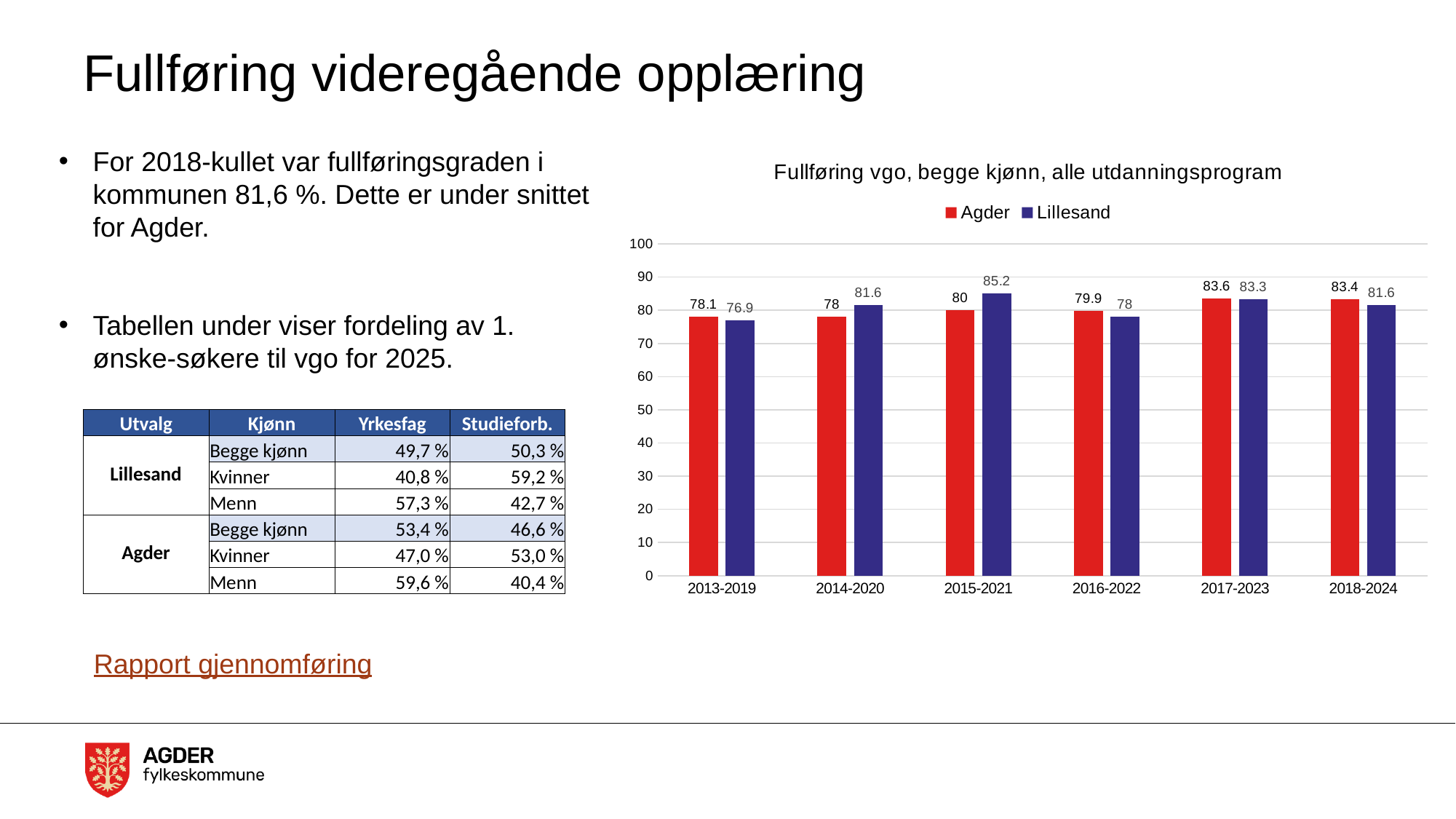
What is the value for Lillesand in 2018-2024? 81.6 What is the difference between the Lillesand and Agder values in 2015-2021? 5.2 Which is larger in 2016-2022, Agder or Lillesand? Agder What is the title of the chart? Fullføring vgo, begge kjønn, alle utdanningsprogram How many periods are shown on the x axis? 6 Which is larger in 2014-2020, Agder or Lillesand? Lillesand How many series does the legend list? 2 What is the value for Agder in 2013-2019? 78.1 In which period is the Agder value highest? 2017-2023 In which period is the Lillesand value lowest? 2013-2019 What kind of chart is shown? Bar chart What is the value for Lillesand in 2015-2021? 85.2